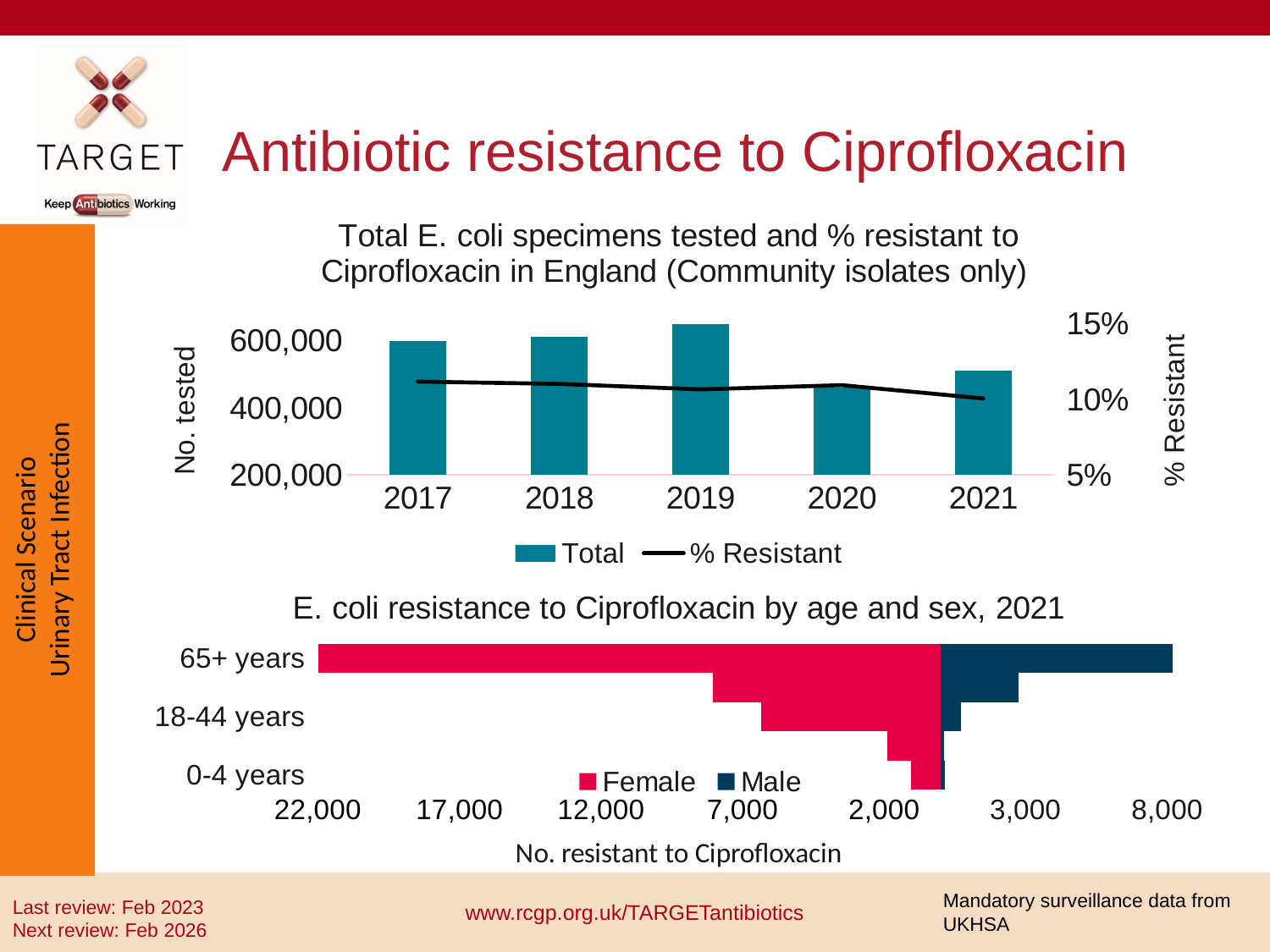
In the top chart, which year has the larger Total number tested, 2018 or 2020? 2018 In the bottom chart, which age group has the highest number of Female resistant isolates? 65+ years In the top chart, is the % Resistant value for 2017 greater or less than 10%? greater In the top chart, is the Total number tested in 2019 greater or less than 600,000? greater In the bottom chart, for the 65+ years group, is the Female or Male number of resistant isolates larger? Female In the top chart, which year has the lowest Total number tested? 2020 In the bottom chart, which two series does the legend list? Female and Male In the top chart, how many series does the legend list? 2 In the top chart, which year has the highest Total number tested? 2019 In the top chart, what kind of chart is used to show the Total series? Bar chart In the top chart, how many years are shown on the x axis? 5 In the top chart, is the Total number tested in 2020 greater or less than 600,000? less